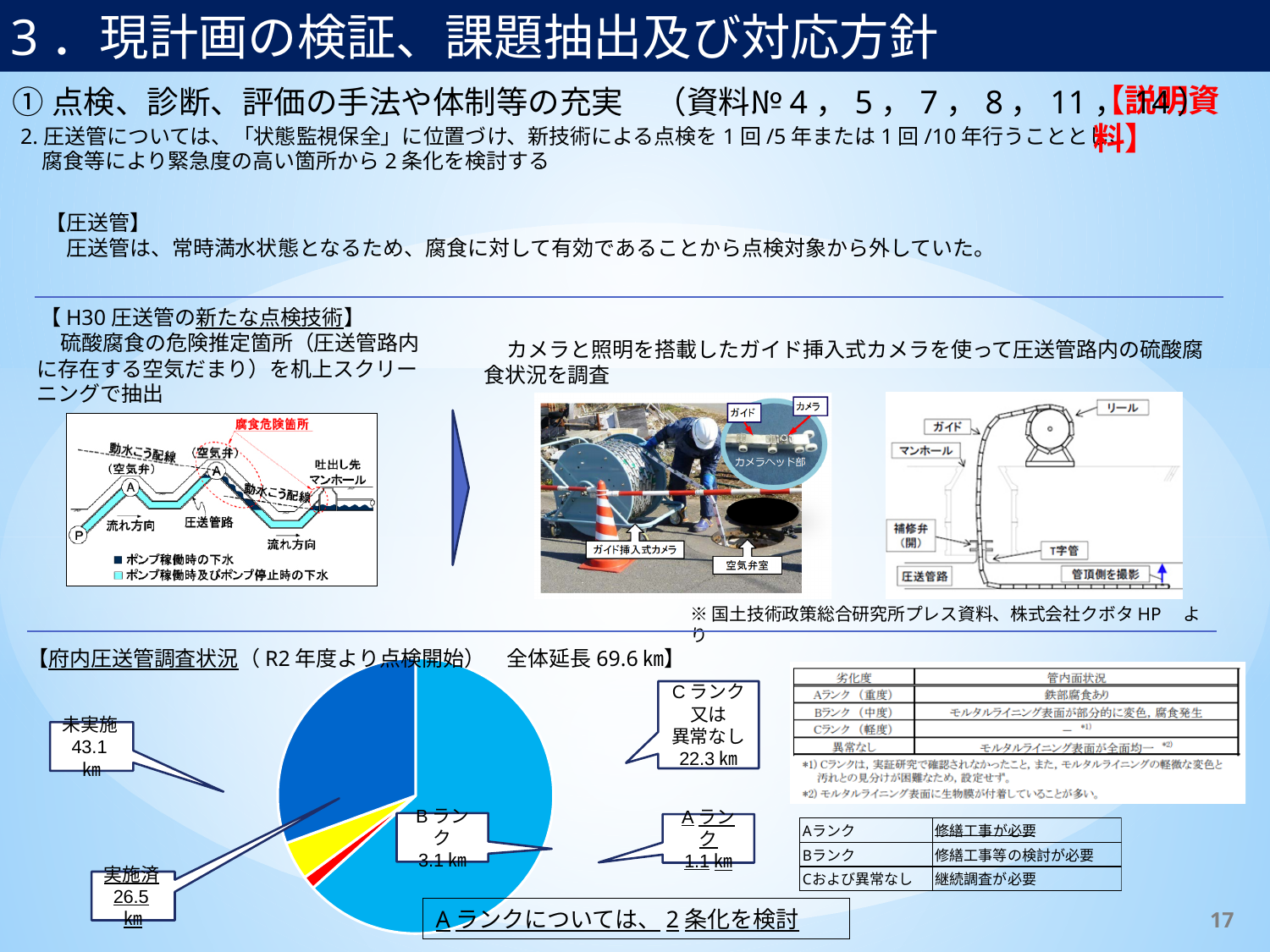
In the pie chart of 府内圧送管調査状況, which category has the smallest slice? Aランク In the pie chart of 府内圧送管調査状況, which category has the largest slice? 未実施 In the pie chart of 府内圧送管調査状況, what is the value for 未実施? 43.1 km In the pie chart of 府内圧送管調査状況, what is the difference between 未実施 and Cランク又は異常なし? 20.8 km What kind of chart is shown at the bottom of the slide under 府内圧送管調査状況? pie chart In the pie chart of 府内圧送管調査状況, which is larger, Bランク or Aランク? Bランク In the pie chart of 府内圧送管調査状況, what is the value for Cランク又は異常なし? 22.3 km In the pie chart of 府内圧送管調査状況, what is the value for Bランク? 3.1 km What is the total length (全体延長) stated for the pie chart of 府内圧送管調査状況? 69.6 km How many slices does the pie chart of 府内圧送管調査状況 have? 4 In the pie chart of 府内圧送管調査状況, what is the value for Aランク? 1.1 km In the pie chart of 府内圧送管調査状況, what is the length labelled as 実施済? 26.5 km